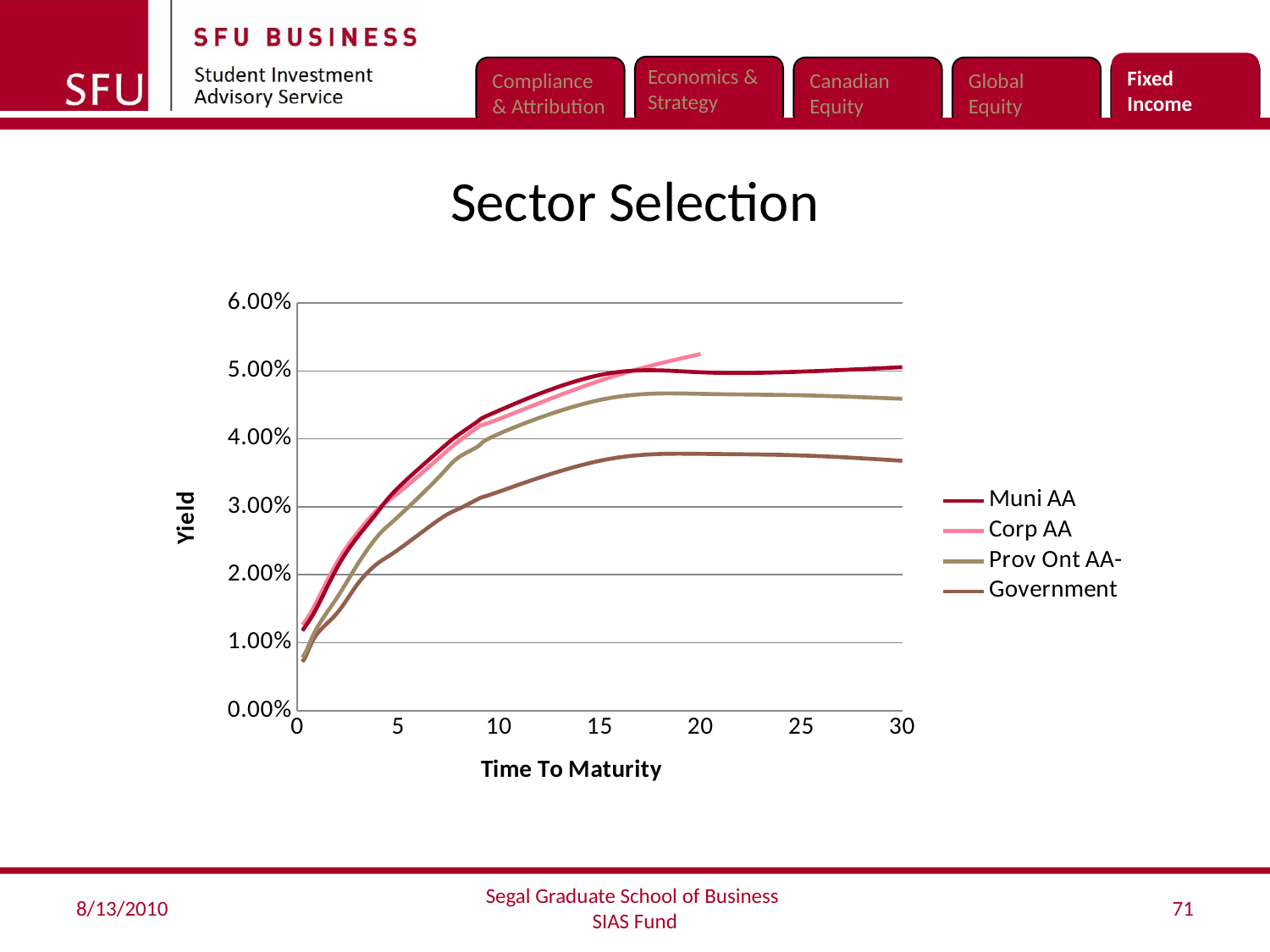
Is the Government yield at a time to maturity of 30 greater or less than 4.00%? less Is the Prov Ont AA- yield at a time to maturity of 30 greater or less than 5.00%? less Is the Corp AA yield at a time to maturity of 20 greater or less than 5.00%? greater Does the Government yield rise or fall as time to maturity increases from 0 to 15? Rise Which series has the highest yield at a time to maturity of 30? Muni AA What is the label of the x axis? Time To Maturity Which series has the lowest yield across all maturities shown? Government How many series does the legend list? 4 What is the title of the chart? Sector Selection At a time to maturity of 30, which has the higher yield, Prov Ont AA- or Government? Prov Ont AA- What kind of chart is shown on the slide? Line chart